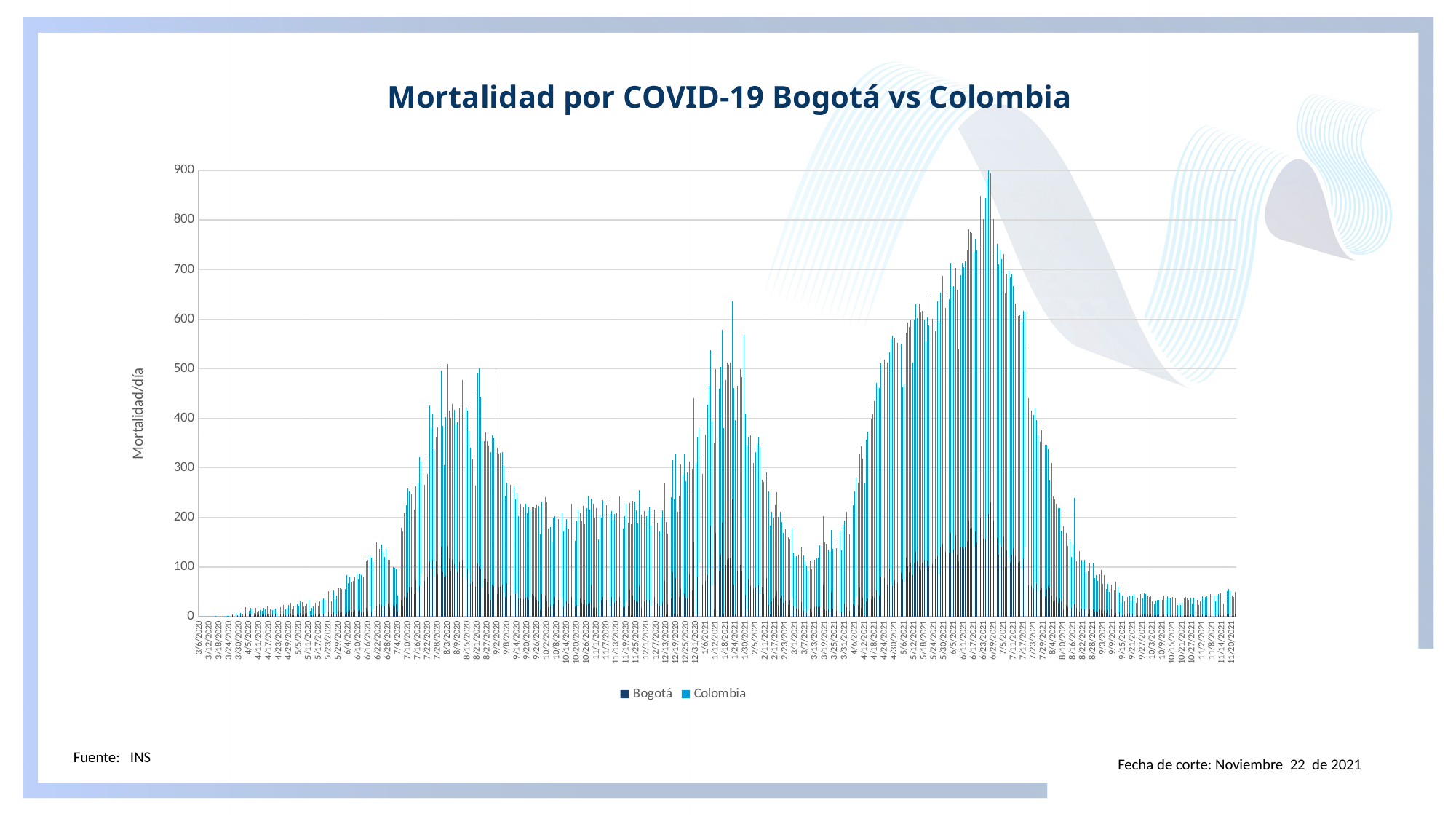
What is the title of the chart? Mortalidad por COVID-19 Bogotá vs Colombia How many series does the legend list? 2 Is the highest Colombia value, around 6/29/2021, greater or less than 800? greater Do the Colombia values rise or fall between 7/5/2021 and 8/28/2021? fall Is the Colombia value around 3/13/2021 greater or less than 300? less What kind of chart is shown on the slide? bar chart Do the Colombia values rise or fall between 3/31/2021 and 6/5/2021? rise Is the Colombia value at the peak around 1/18/2021 greater or less than 500? greater Which series reaches the highest value on the chart, Bogotá or Colombia? Colombia What is the label on the vertical axis of the chart? Mortalidad/día Around 6/23/2021, which series has the larger value, Bogotá or Colombia? Colombia